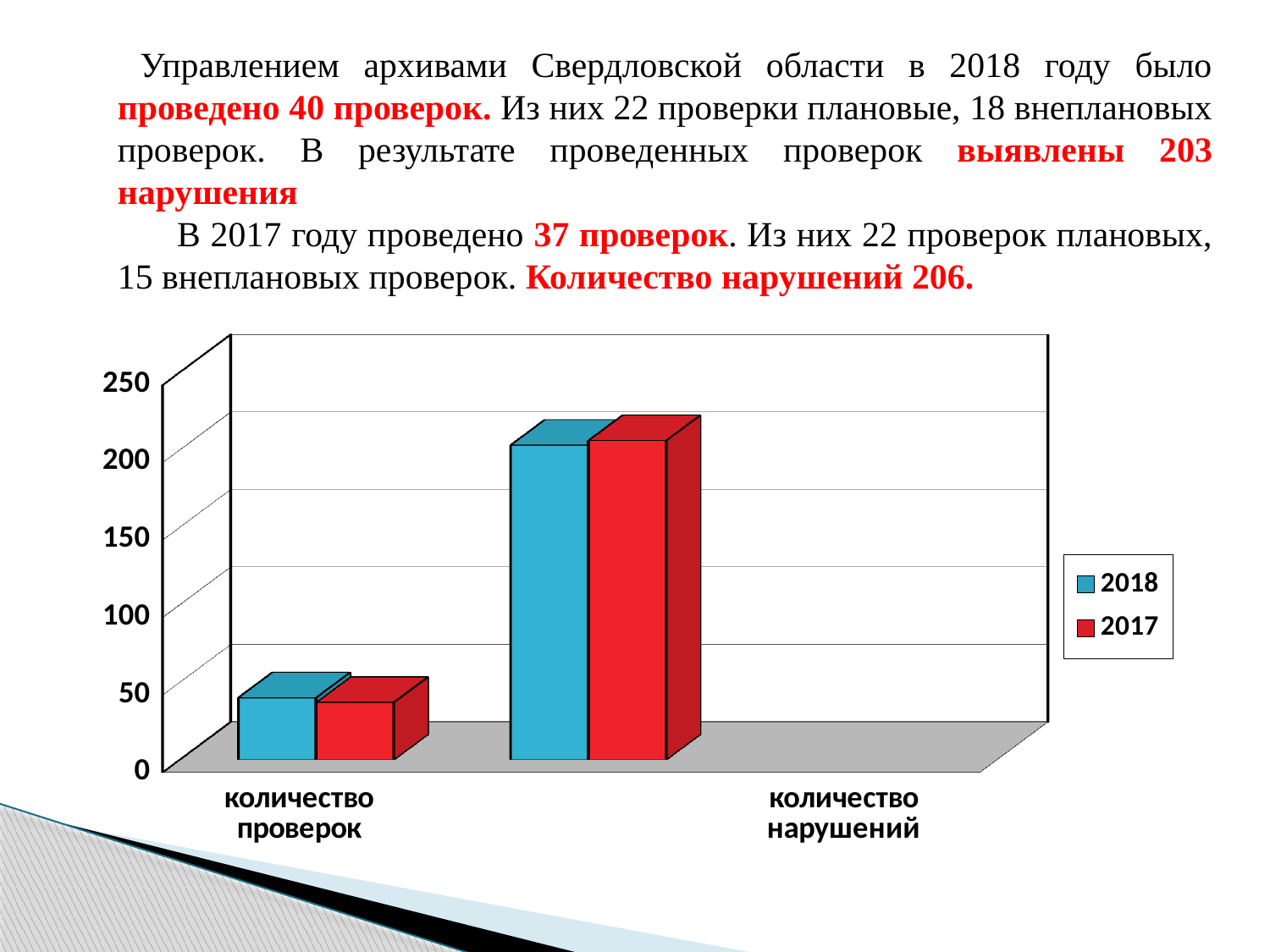
Which category has the lowest bars in the chart? количество проверок Is the 2018 value for количество нарушений greater or less than 100? greater Which category has the highest bars in the chart? количество нарушений Is the 2018 value for количество проверок greater or less than 100? less What are the two categories on the x axis of the chart? количество проверок, количество нарушений Is the 2017 value for количество нарушений greater or less than 150? greater How many categories are shown on the x axis of the chart? 2 Which years are listed in the chart legend? 2018 and 2017 What kind of chart is shown on the slide? bar chart What colour represents the 2017 series in the chart? red For 2018, which is larger: количество проверок or количество нарушений? количество нарушений How many series does the legend list? 2